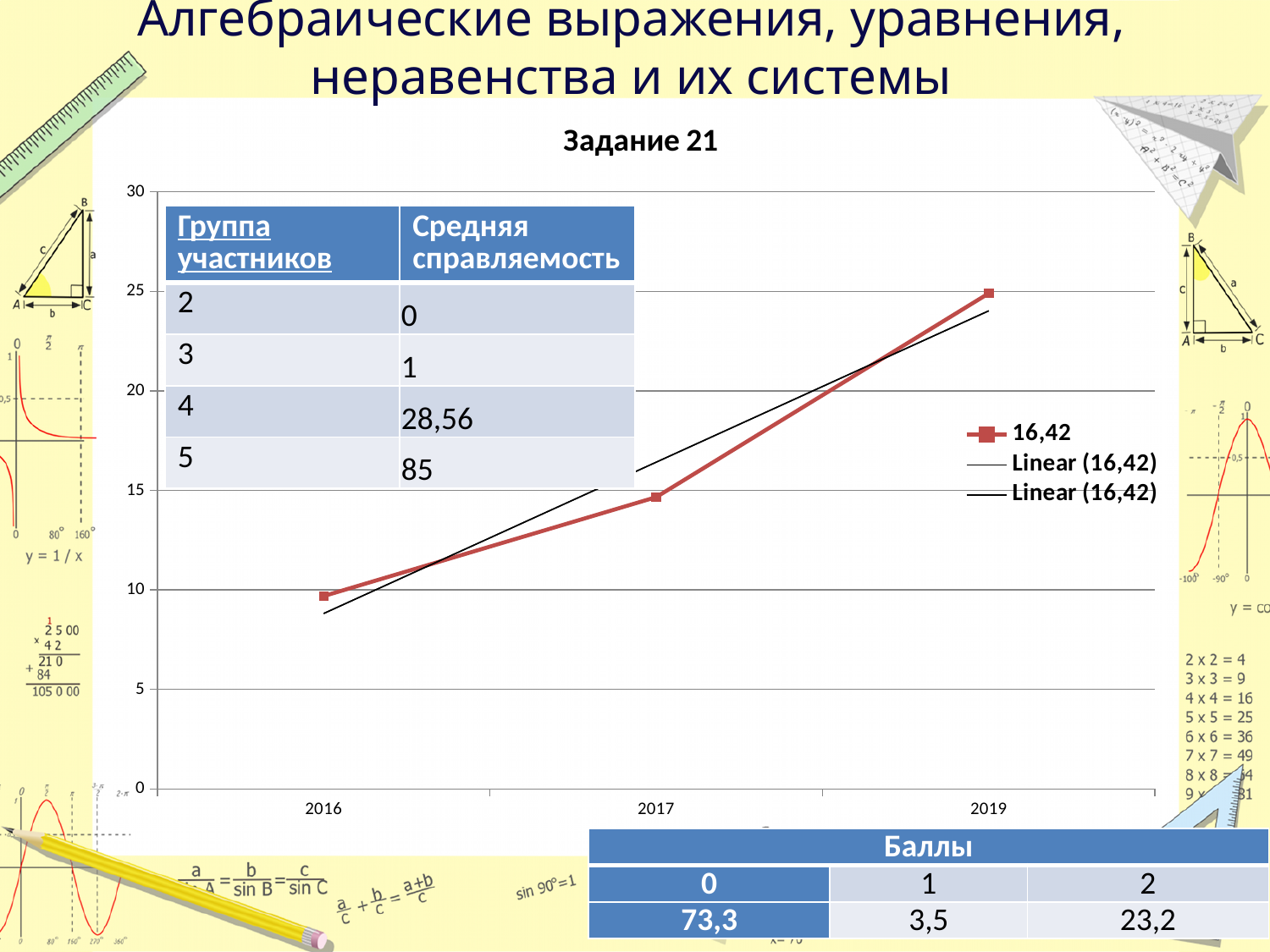
Is the value for 2017 greater or less than 10? greater What is the title of the chart? Задание 21 Do the values on the red line rise or fall from 2016 to 2019? rise Which year has the lowest value on the red line? 2016 Is the value for 2016 greater or less than 15? less What kind of chart is shown on the slide? line chart Is the value for 2019 greater or less than 20? greater How many data points are plotted on the red line? 3 What is the name of the data series shown with red square markers in the legend? 16,42 How many entries does the chart legend list? 3 Which year has the highest value on the red line? 2019 Which year has the larger value, 2016 or 2017? 2017